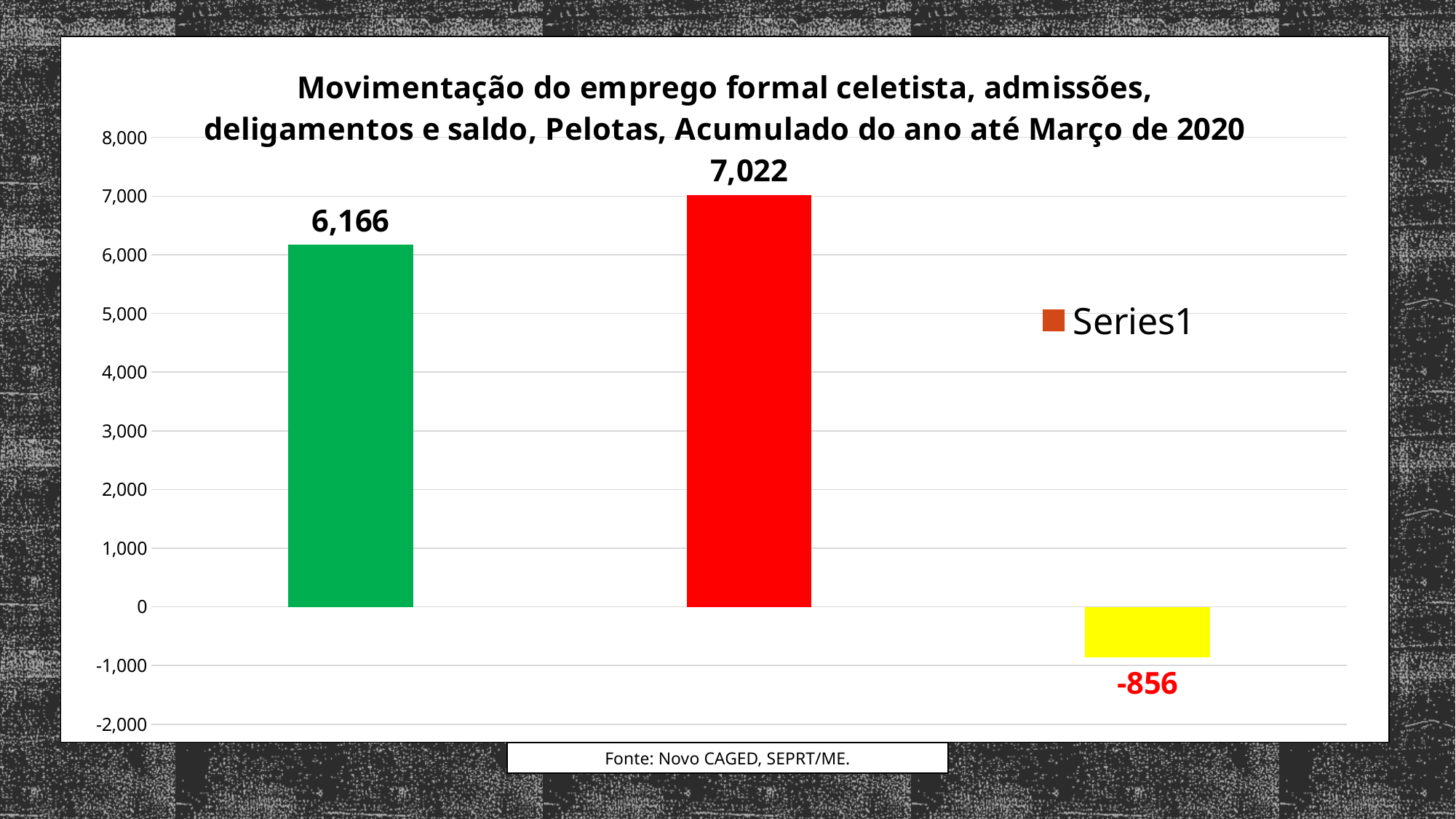
What kind of chart is shown on the slide? Bar chart Which bar has the lowest value? The yellow (rightmost) bar, -856 How many series does the legend list? 1 How many bars are plotted in the chart? 3 Which is larger, the value of the green bar or the value of the red bar? The red bar What is the difference between the red bar's value and the green bar's value? 856 What value is shown on the red bar (the middle bar)? 7,022 What value is shown on the yellow bar (the rightmost bar)? -856 What is the name of the series shown in the legend? Series1 What value is shown on the green bar (the first bar from the left)? 6,166 Which bar has the highest value? The red (middle) bar, 7,022 Is the value of the green bar greater or less than 6,000? greater